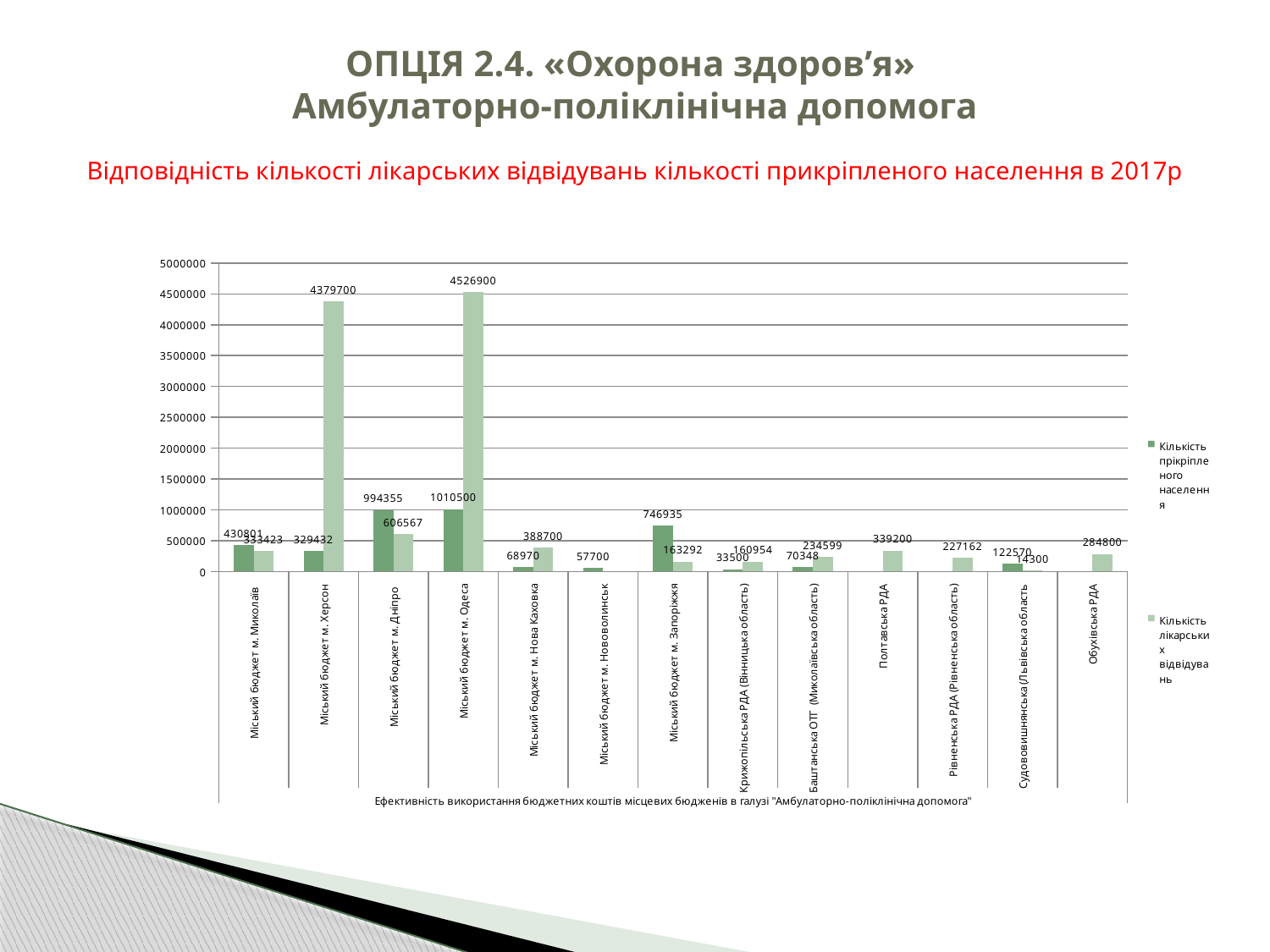
What is the value of Кількість лікарських відвідувань for Полтавська РДА? 339200 Which category has the highest value of Кількість лікарських відвідувань? Міський бюджет м. Одеса Which category has the lowest value of Кількість прікріпленого населення? Крижопільська РДА (Вінницька область) What is the difference between Кількість лікарських відвідувань and Кількість прікріпленого населення for Міський бюджет м. Одеса? 3516400 How many series does the legend list? 2 Is the value of Кількість лікарських відвідувань for Міський бюджет м. Херсон greater or less than 4000000? greater How many categories are shown on the x axis of the chart? 13 For Міський бюджет м. Дніпро, which is larger: Кількість прікріпленого населення or Кількість лікарських відвідувань? Кількість прікріпленого населення What is the value of Кількість лікарських відвідувань for Міський бюджет м. Херсон? 4379700 What kind of chart is shown on the slide? bar chart What is the value of Кількість прікріпленого населення for Міський бюджет м. Одеса? 1010500 What is the axis title shown below the categories of the chart? Ефективність використання бюджетних коштів місцевих бюдженів в галузі "Амбулаторно-поліклінічна допомога"